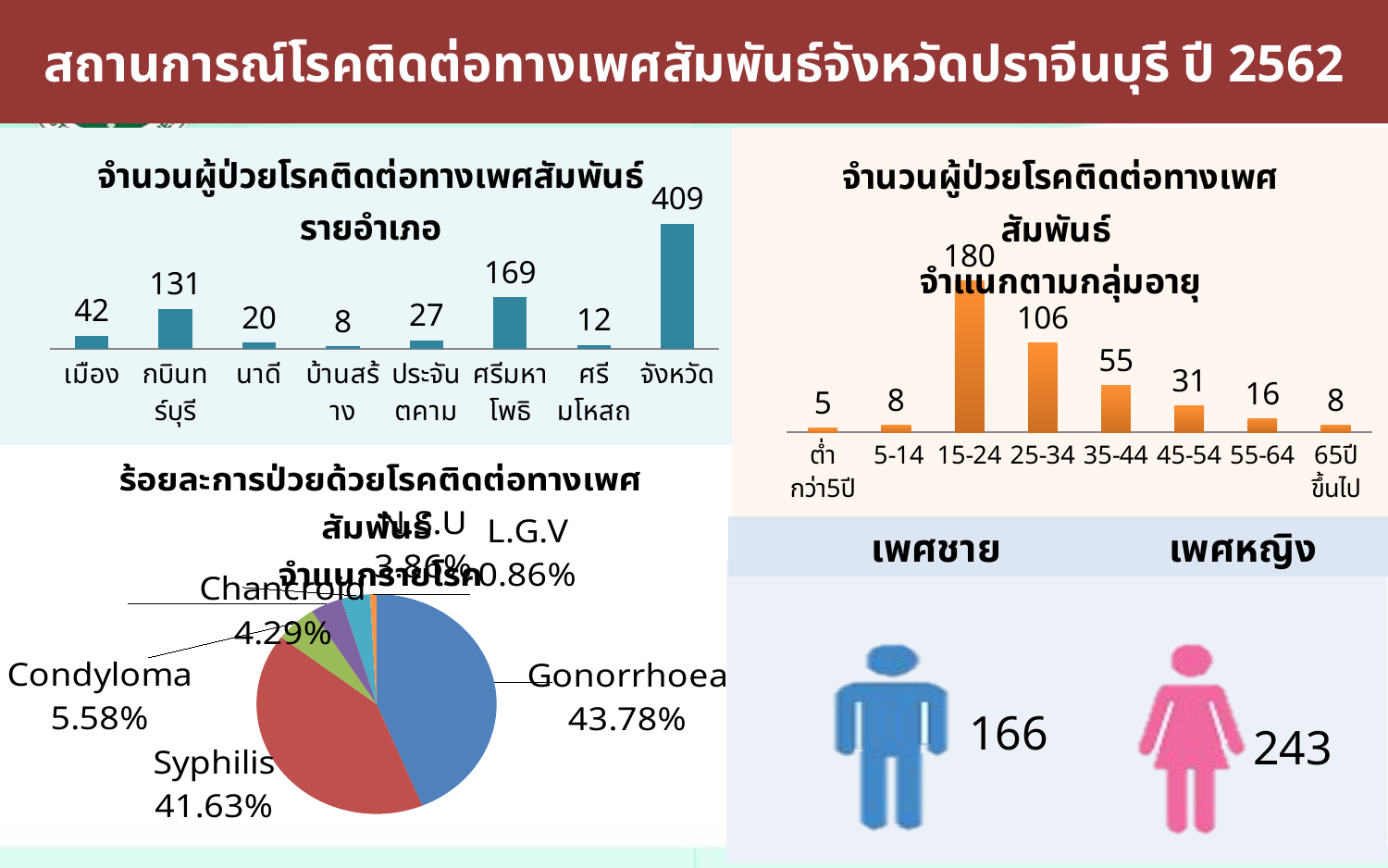
In the top-left bar chart (by district), what is the difference between กบินทร์บุรี and เมือง? 89 In the bottom-left pie chart, how many slices are there? 6 In the top-right bar chart (by age group), which age group has the highest value? 15-24 In the top-left bar chart (by district), how many bars are plotted? 8 In the top-right bar chart (by age group), what is the value for 35-44? 55 In the top-left bar chart (by district), what is the value for ศรีมหาโพธิ? 169 In the top-left bar chart (by district), which district has the lowest value? บ้านสร้าง In the top-right bar chart (by age group), what is the difference between 15-24 and 25-34? 74 In the top-right bar chart (by age group), which is larger: 25-34 or 45-54? 25-34 In the bottom-left pie chart, which disease has the smallest share? L.G.V In the bottom-left pie chart, what share does Syphilis have? 41.63% What kind of chart is the bottom-left chart showing percentages by disease? pie chart